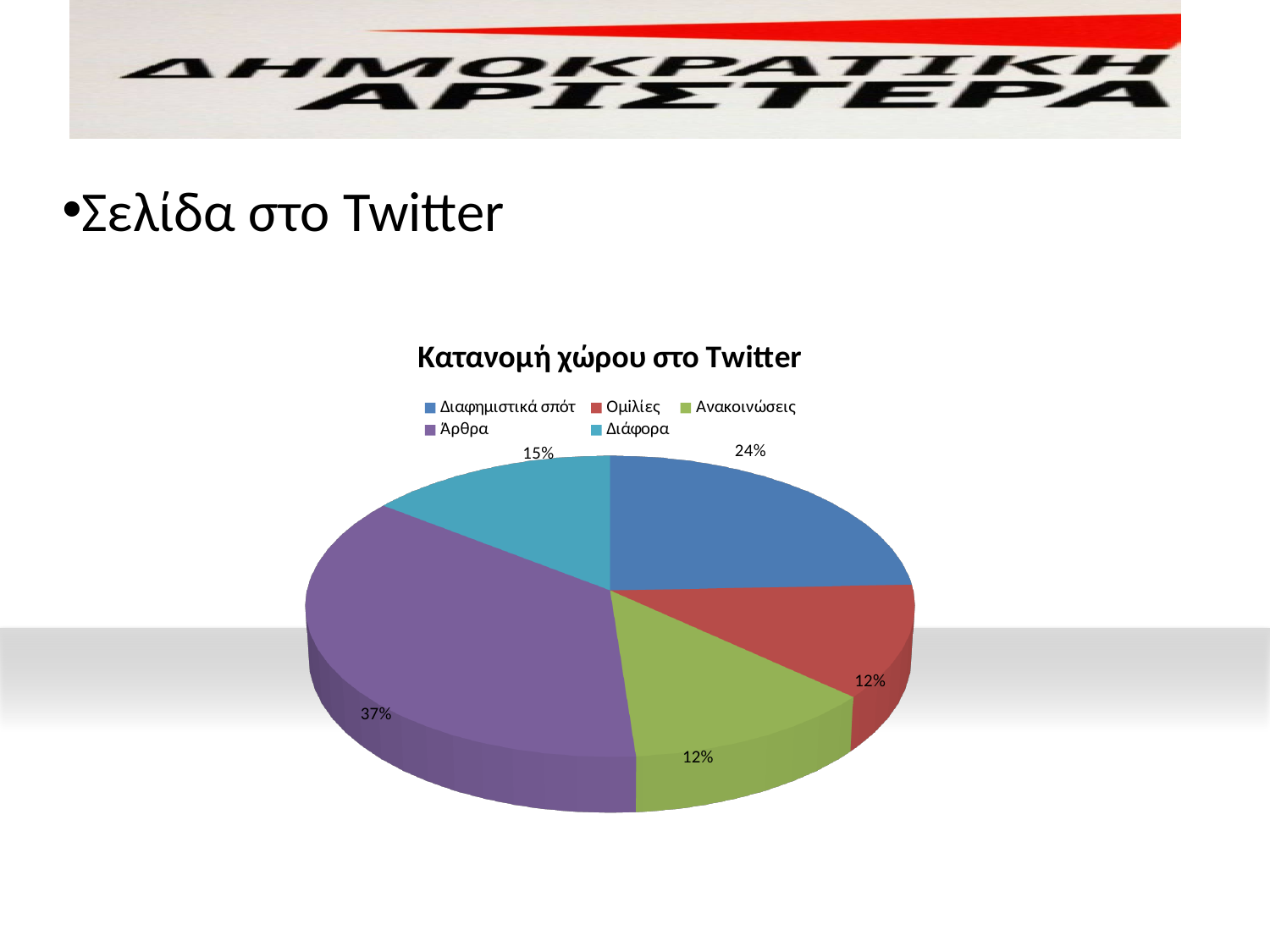
Is the share for Άρθρα greater or less than 30%? greater Which is larger, the slice for Διαφημιστικά σπότ or the slice for Διάφορα? Διαφημιστικά σπότ How many slices does the pie chart have? 5 Which category has the largest slice of the pie? Άρθρα What share of the pie does Διάφορα have? 15% What share of the pie does Ομιλίες have? 12% What share of the pie does Διαφημιστικά σπότ have? 24% What is the title of the chart? Κατανομή χώρου στο Twitter Which colour represents Ανακοινώσεις in the pie chart? green What kind of chart is shown on the slide? pie chart What is the difference in percentage points between the Άρθρα slice and the Διαφημιστικά σπότ slice? 13